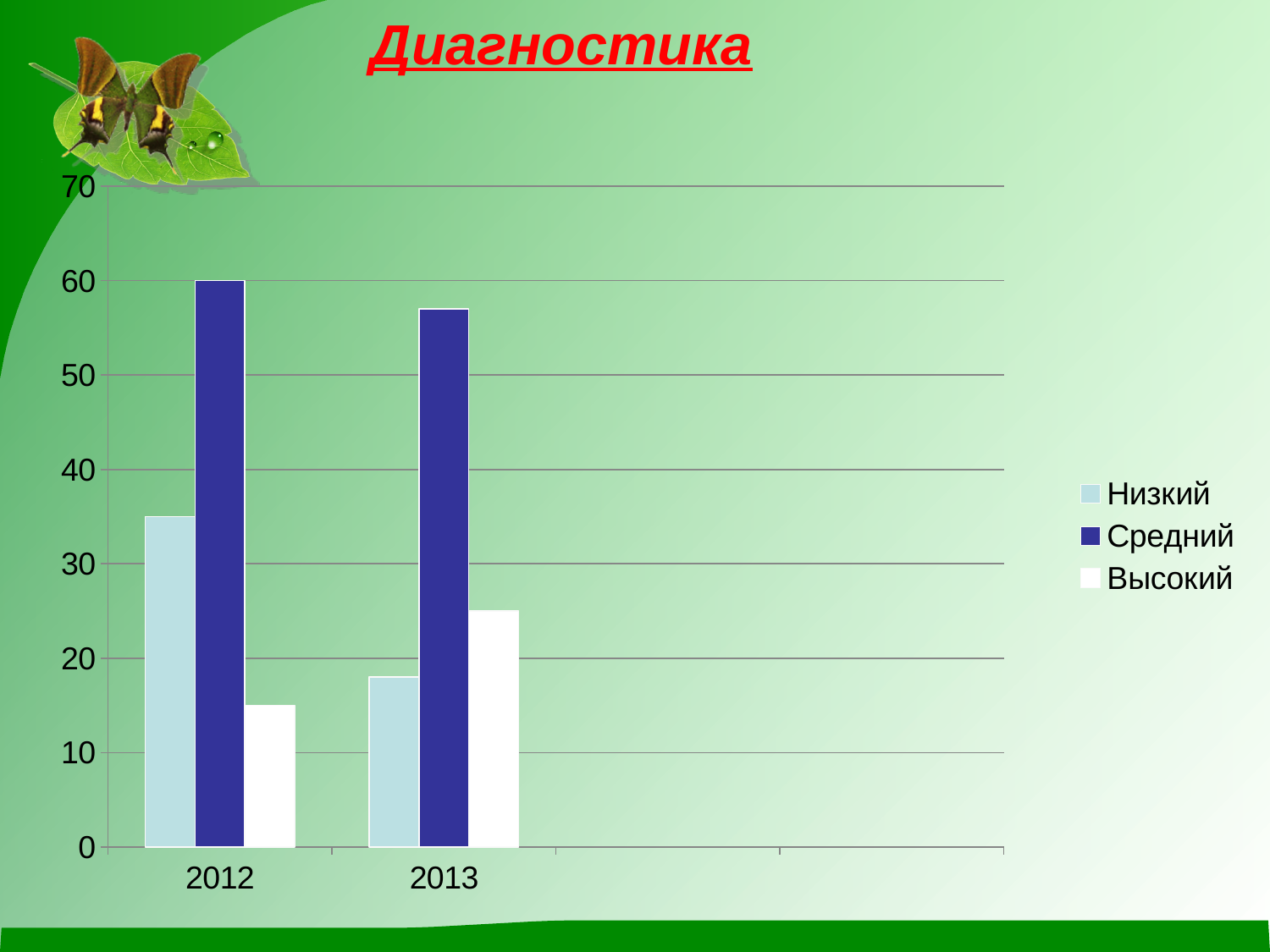
Which series has the highest value in 2012? Средний How many series does the legend list? 3 Is the value for Низкий in 2013 greater or less than 20? less What is the value for Средний in 2012? 60 Is the value for Высокий in 2013 greater or less than 30? less Which series has the lowest value in 2012? Высокий Which series has the lowest value in 2013? Низкий Is the value for Низкий in 2012 greater or less than 30? greater Which is larger, Высокий in 2012 or Высокий in 2013? Высокий in 2013 How many categories are shown on the x axis? 2 What kind of chart is shown on the slide? bar chart Does the value for Низкий rise or fall from 2012 to 2013? fall